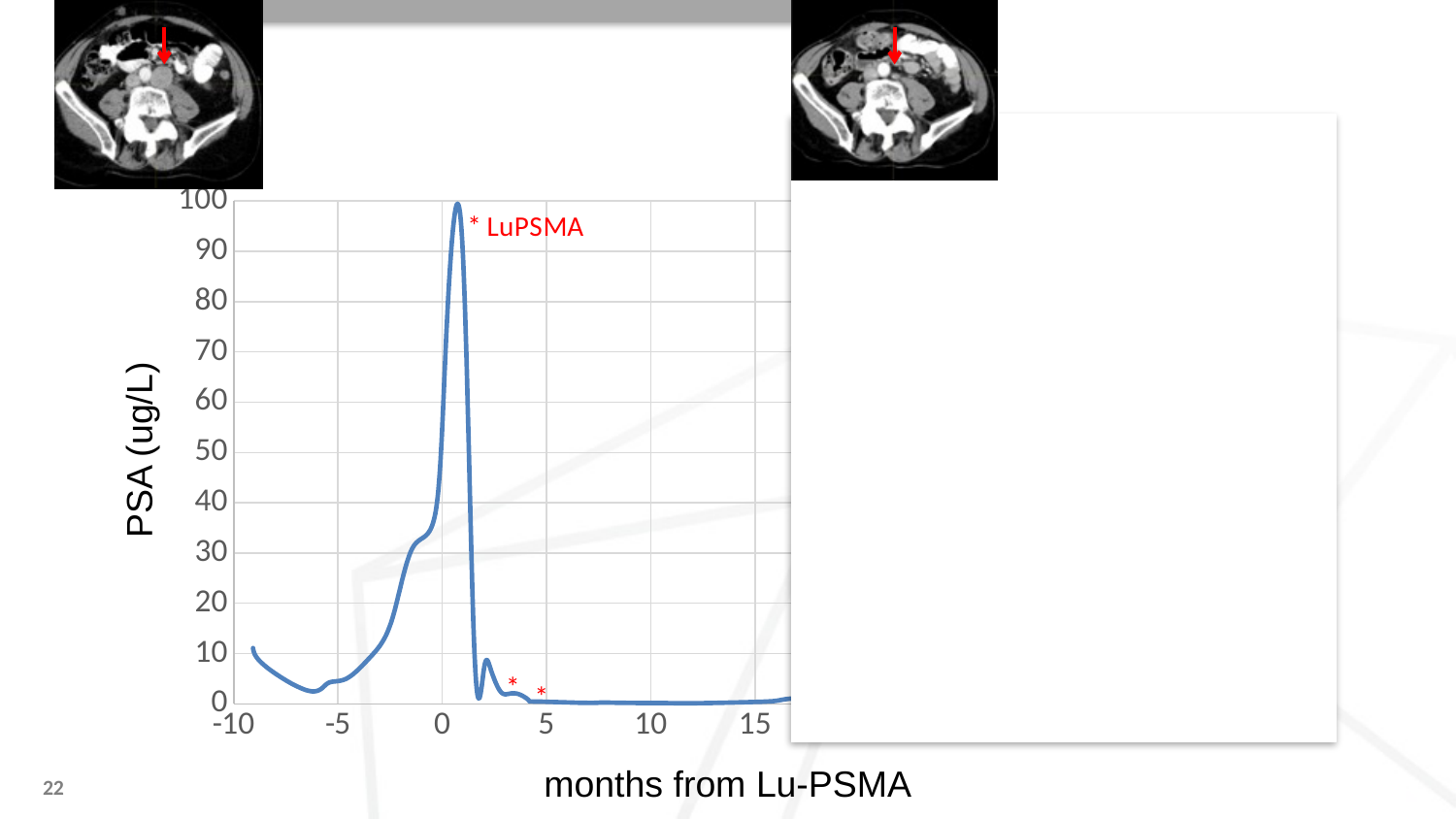
Is the PSA value at month 10 greater or less than 10? less Which is larger, the PSA value at month -5 or the PSA value at month 0? month 0 Is the PSA value at month 5 greater or less than 20? less Is the PSA value at month 15 greater or less than 10? less What kind of chart is shown on the slide? line chart Between month -5 and month 0, does the PSA value rise or fall? rise According to the red annotation on the chart, what does a red asterisk mark? LuPSMA What is the label of the y axis of the chart? PSA (ug/L) What is the highest value shown on the y axis of the chart? 100 Between month 1 and month 5, does the PSA value rise or fall? fall